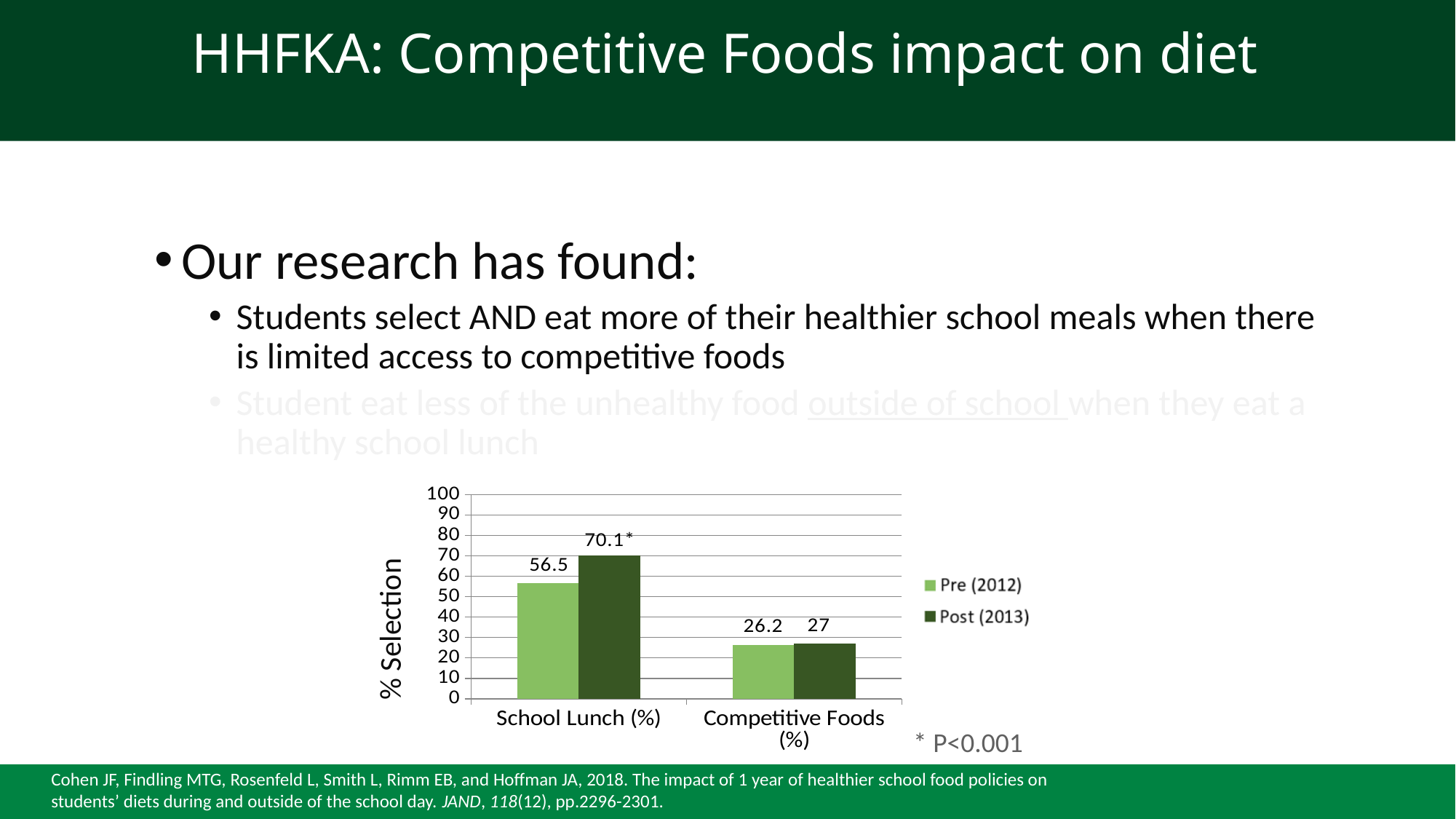
What is the Post (2013) value for Competitive Foods (%)? 27 What is the label of the y axis? % Selection Which bar has the highest value in the chart? Post (2013) for School Lunch (%) What kind of chart is shown on the slide? bar chart Which is larger, the Pre (2012) value for School Lunch (%) or the Pre (2012) value for Competitive Foods (%)? School Lunch (%) What is the difference between the Post (2013) and Pre (2012) values for Competitive Foods (%)? 0.8 What is the Post (2013) value for School Lunch (%)? 70.1 What is the Pre (2012) value for Competitive Foods (%)? 26.2 Which bar has the lowest value in the chart? Pre (2012) for Competitive Foods (%) How many series does the legend list? 2 What is the Pre (2012) value for School Lunch (%)? 56.5 What is the difference between the Post (2013) and Pre (2012) values for School Lunch (%)? 13.6